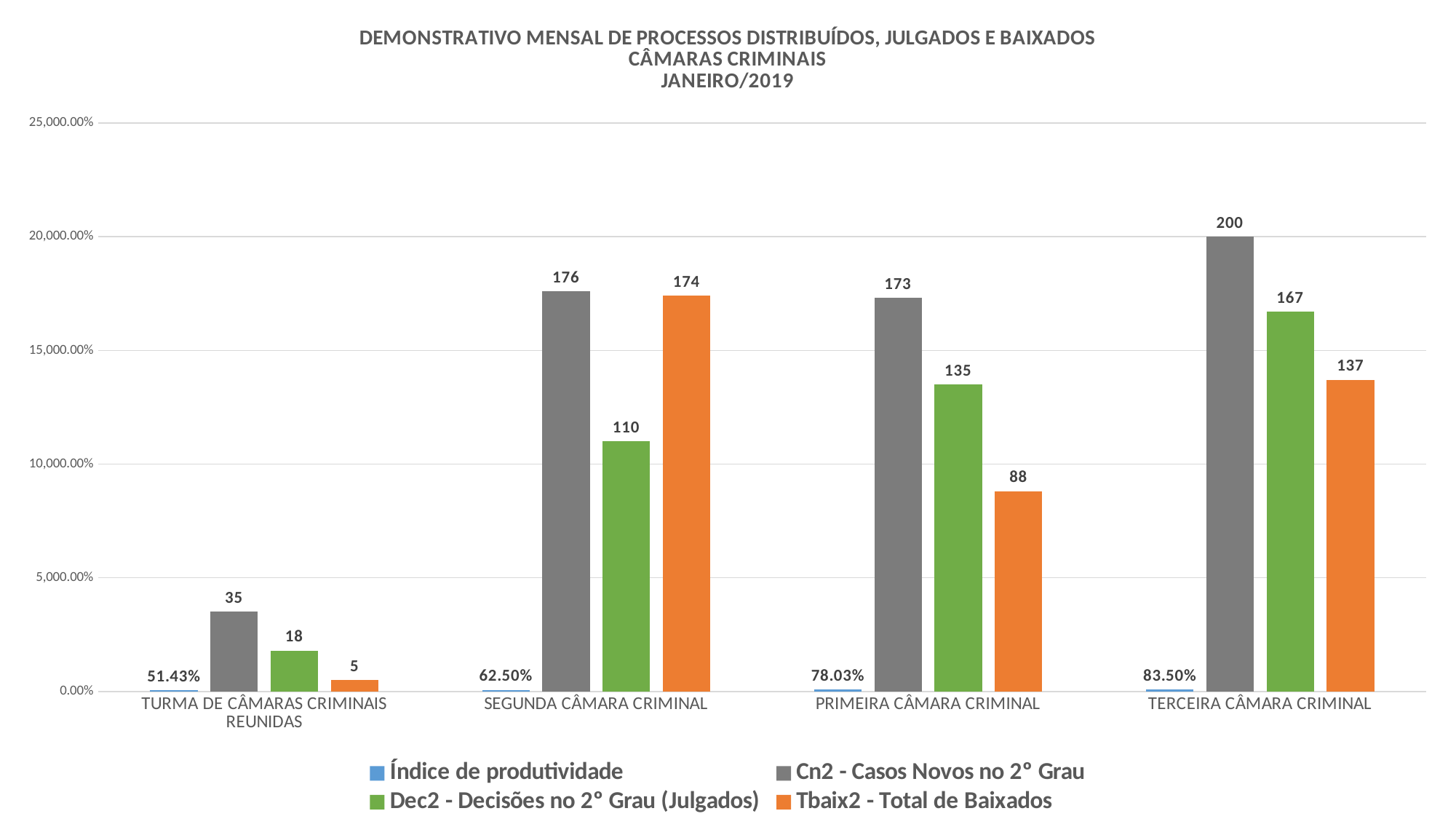
What colour represents Tbaix2 - Total de Baixados in the chart? Orange How many categories are shown on the x axis? 4 How many series does the legend list? 4 Which is larger for SEGUNDA CÂMARA CRIMINAL: Dec2 - Decisões no 2° Grau (Julgados) or Tbaix2 - Total de Baixados? Tbaix2 - Total de Baixados What is the Índice de produtividade for TERCEIRA CÂMARA CRIMINAL? 83.50% What kind of chart is shown on the slide? Bar chart What is the value of Cn2 - Casos Novos no 2° Grau for SEGUNDA CÂMARA CRIMINAL? 176 What is the difference between Cn2 - Casos Novos no 2° Grau and Dec2 - Decisões no 2° Grau (Julgados) for PRIMEIRA CÂMARA CRIMINAL? 38 What is the value of Tbaix2 - Total de Baixados for PRIMEIRA CÂMARA CRIMINAL? 88 Which category has the highest value for Cn2 - Casos Novos no 2° Grau? TERCEIRA CÂMARA CRIMINAL What is the value of Dec2 - Decisões no 2° Grau (Julgados) for TURMA DE CÂMARAS CRIMINAIS REUNIDAS? 18 Which category has the lowest Índice de produtividade? TURMA DE CÂMARAS CRIMINAIS REUNIDAS